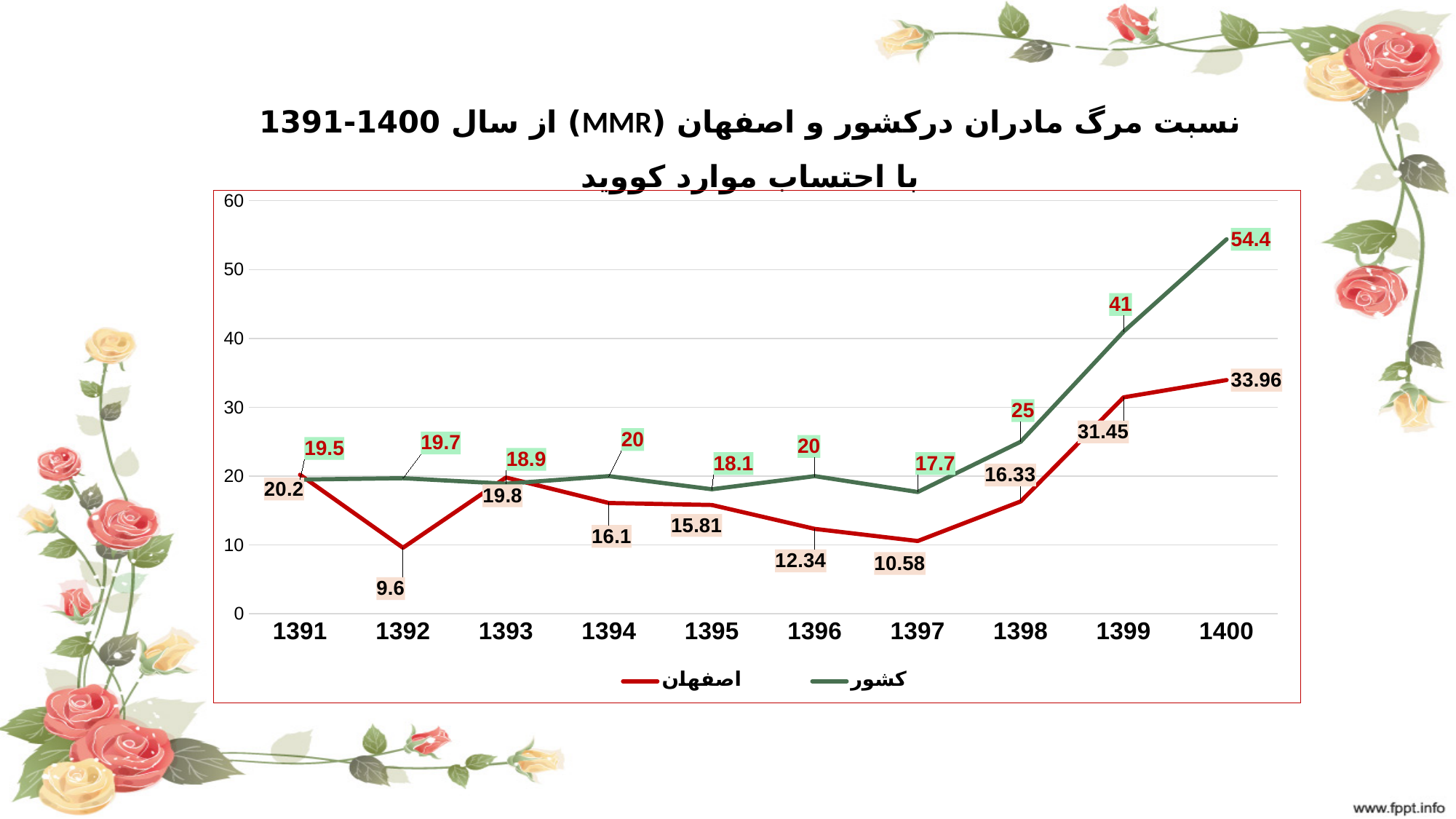
In which year is the کشور series highest? 1400 Does the کشور series rise or fall from 1397 to 1400? rise What is the value for کشور in 1400? 54.4 What is the value for اصفهان in 1397? 10.58 What is the value for اصفهان in 1392? 9.6 What is the difference between the کشور and اصفهان values in 1400? 20.44 What type of chart is shown on the slide? line chart How many years are shown on the x axis? 10 What colour is the line for اصفهان? red In which year is the اصفهان series lowest? 1392 How many series does the legend list? 2 Which series has the larger value in 1399, اصفهان or کشور? کشور